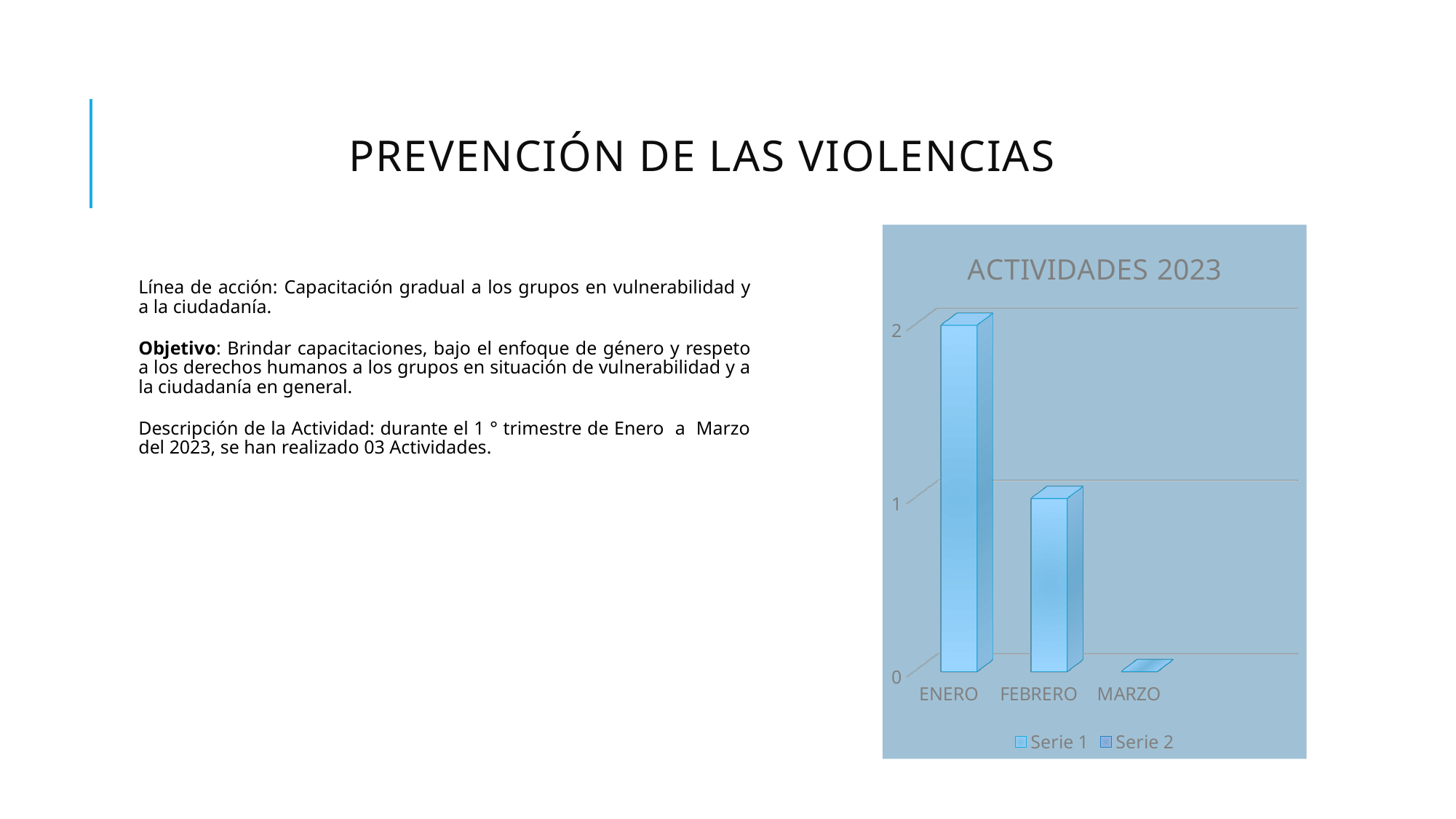
Which month has the highest bar in the chart? ENERO How many series does the chart legend list? 2 Do the bar values rise or fall from ENERO to MARZO? fall What is the value of the bar for ENERO? 2 What kind of chart is shown on the slide? bar chart Which is larger, the bar for ENERO or the bar for FEBRERO? ENERO Which month has the lowest bar in the chart? MARZO How many categories are shown on the x axis of the chart? 3 What is the title of the chart? ACTIVIDADES 2023 Is the value for ENERO greater or less than 1? greater What are the names of the series listed in the chart legend? Serie 1 and Serie 2 What is the value of the bar for FEBRERO? 1